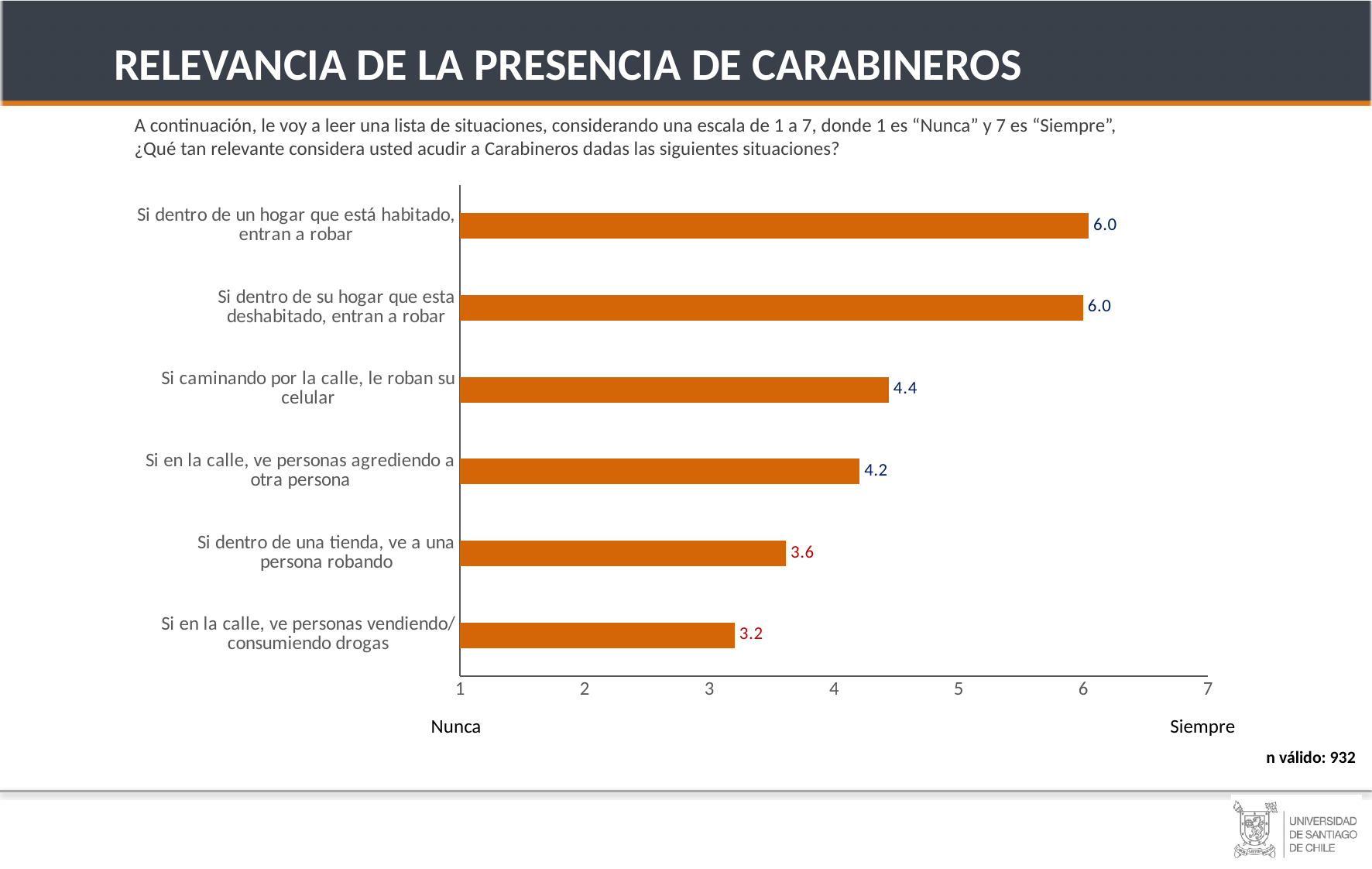
What is the value for "Si dentro de su hogar que esta deshabitado, entran a robar"? 6.0 Is the value for "Si dentro de un hogar que está habitado, entran a robar" greater or less than 5? greater What is the value for "Si dentro de una tienda, ve a una persona robando"? 3.6 How many categories are shown in the chart? 6 What is the value for "Si en la calle, ve personas agrediendo a otra persona"? 4.2 What is the value for "Si caminando por la calle, le roban su celular"? 4.4 What label appears at the right end of the x axis, under the value 7? Siempre Which category has the lowest value? Si en la calle, ve personas vendiendo/consumiendo drogas Which is larger: the value for "Si dentro de una tienda, ve a una persona robando" or the value for "Si en la calle, ve personas agrediendo a otra persona"? Si en la calle, ve personas agrediendo a otra persona What is the difference between the value for "Si caminando por la calle, le roban su celular" and the value for "Si en la calle, ve personas vendiendo/consumiendo drogas"? 1.2 What is the value for "Si en la calle, ve personas vendiendo/consumiendo drogas"? 3.2 What kind of chart is shown on the slide? bar chart